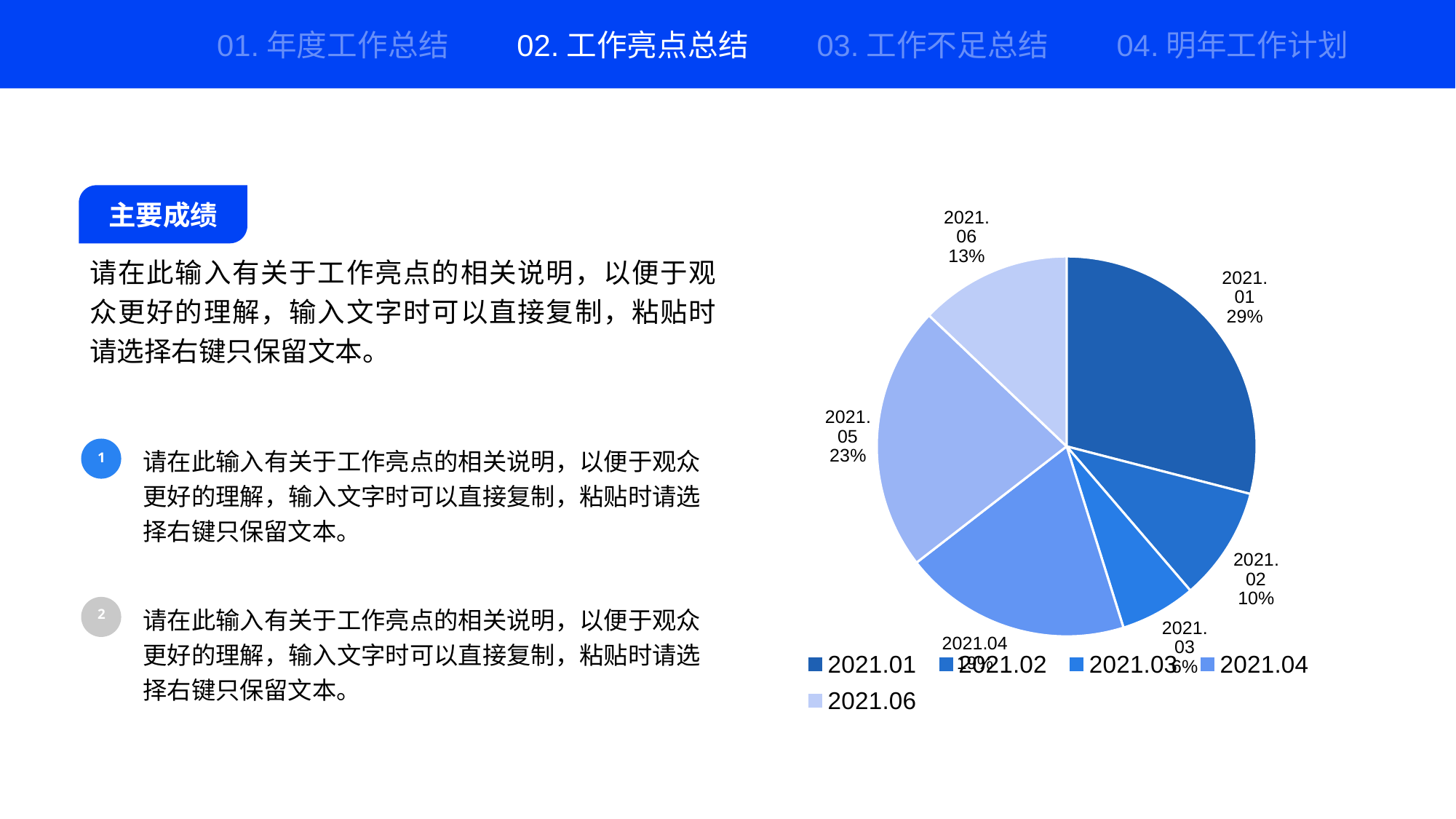
How many percentage points larger is the 2021.06 slice than the 2021.02 slice? 3 percentage points What share of the pie does 2021.01 represent? 29% What share of the pie does 2021.02 represent? 10% How many percentage points larger is the 2021.01 slice than the 2021.05 slice? 6 percentage points What share of the pie does 2021.06 represent? 13% Which category has the smallest slice of the pie? 2021.03 Which category has the largest slice of the pie? 2021.01 Which slice is larger, 2021.05 or 2021.06? 2021.05 Which slice is drawn in the lightest shade of blue? 2021.06 How many slices does the pie chart have? 6 What share of the pie does 2021.05 represent? 23% What type of chart is shown on the slide? pie chart